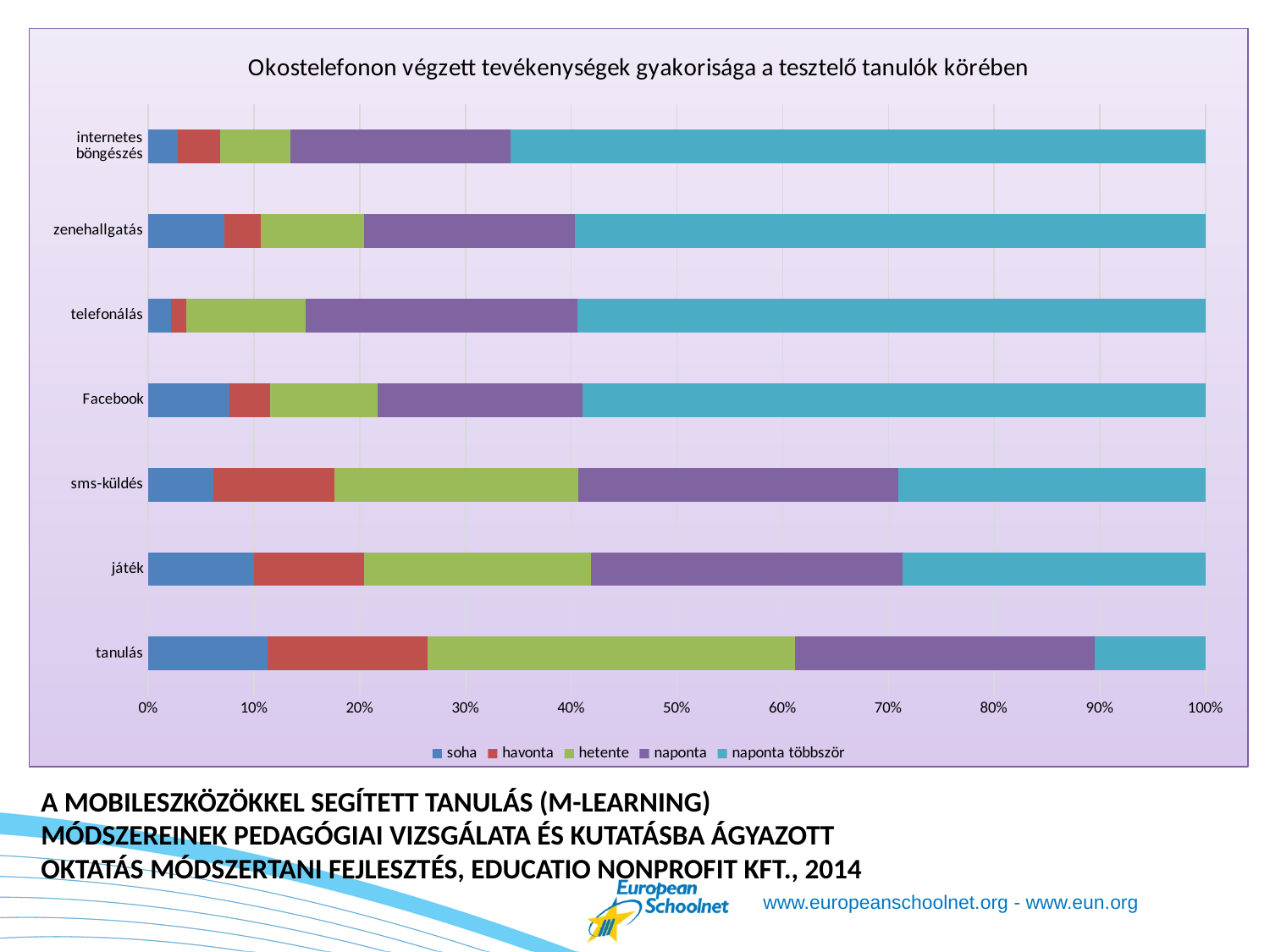
Which activity has the smallest 'naponta többször' share? tanulás Which has a larger 'havonta' share, tanulás or telefonálás? tanulás Which activity has the largest 'naponta többször' share? internetes böngészés Which legend entry is shown in green? hetente What kind of chart is shown on the slide? bar chart What is the title of the chart? Okostelefonon végzett tevékenységek gyakorisága a tesztelő tanulók körében How many activity categories are shown on the chart? 7 How many series does the legend list? 5 Is the 'naponta többször' share for internetes böngészés greater or less than 50%? greater Which has a larger 'naponta többször' share, internetes böngészés or tanulás? internetes böngészés Is the 'naponta többször' share for tanulás greater or less than 20%? less Which activity has the largest 'hetente' share? tanulás